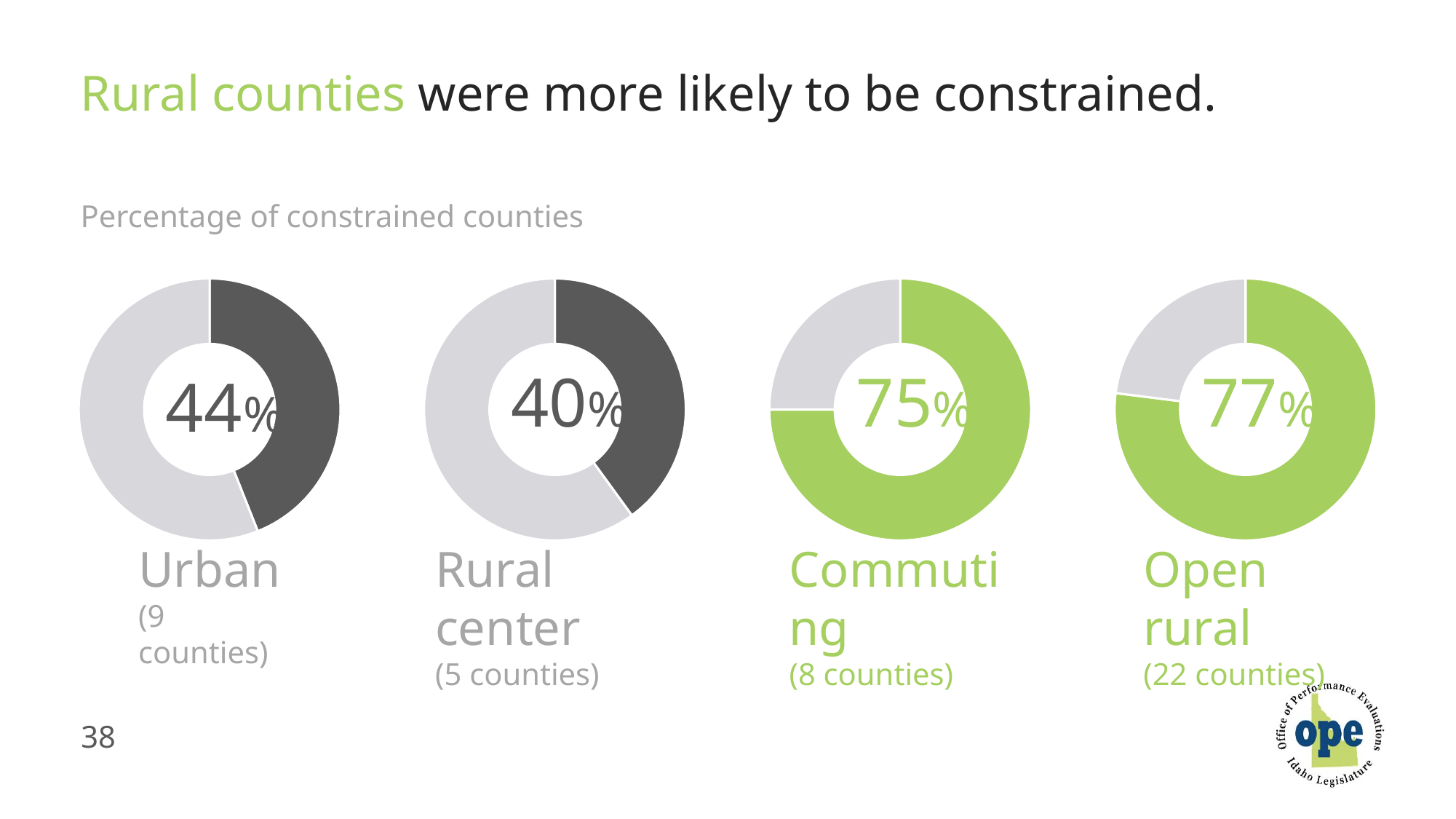
What percentage is shown in the Open rural donut chart? 77% What is the difference in percentage points between the Open rural chart and the Urban chart? 33 Which county type has the lowest percentage of constrained counties across the four donut charts? Rural center Which county type has the highest percentage of constrained counties across the four donut charts? Open rural What kind of chart is used to show the percentage of constrained counties for each county type? Donut (pie) chart Which has a higher percentage of constrained counties, the Urban chart or the Rural center chart? Urban What is the difference in percentage points between the Commuting chart and the Rural center chart? 35 How many counties are included in the Open rural donut chart? 22 counties What percentage is shown in the centre of the Rural center donut chart? 40% What percentage of Urban counties were constrained, according to the Urban donut chart? 44% How many donut charts are shown on the slide? 4 What percentage of Commuting counties were constrained, according to the Commuting donut chart? 75%